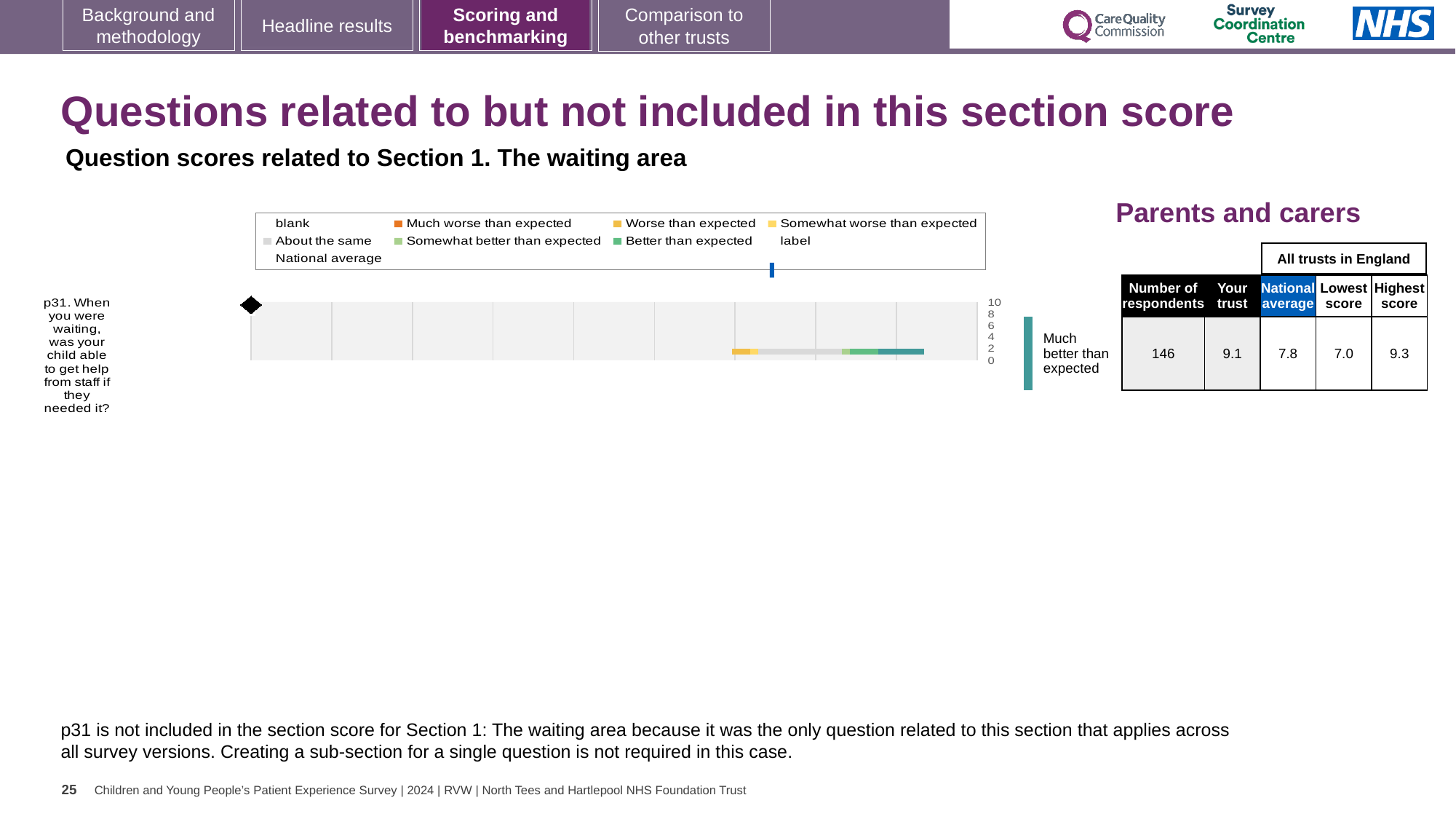
In the table beside the chart, what is the national average score for p31? 7.8 In the table beside the chart, what is the highest score among all trusts in England for p31? 9.3 In the table beside the chart, how many respondents answered p31? 146 How many questions (categories) are plotted on the chart? 1 In the table beside the chart, what is the lowest score among all trusts in England for p31? 7.0 Which legend entry is shown in orange? Much worse than expected In the table beside the chart, what is the 'Your trust' score for p31? 9.1 Is the 'Your trust' score for p31 higher or lower than the national average? higher What kind of chart is used to show the benchmarking result for question p31? bar chart Which question is plotted on the chart? p31. When you were waiting, was your child able to get help from staff if they needed it? What benchmarking rating is shown beside the chart for question p31? Much better than expected What is the difference between the 'Your trust' score and the national average for p31? 1.3